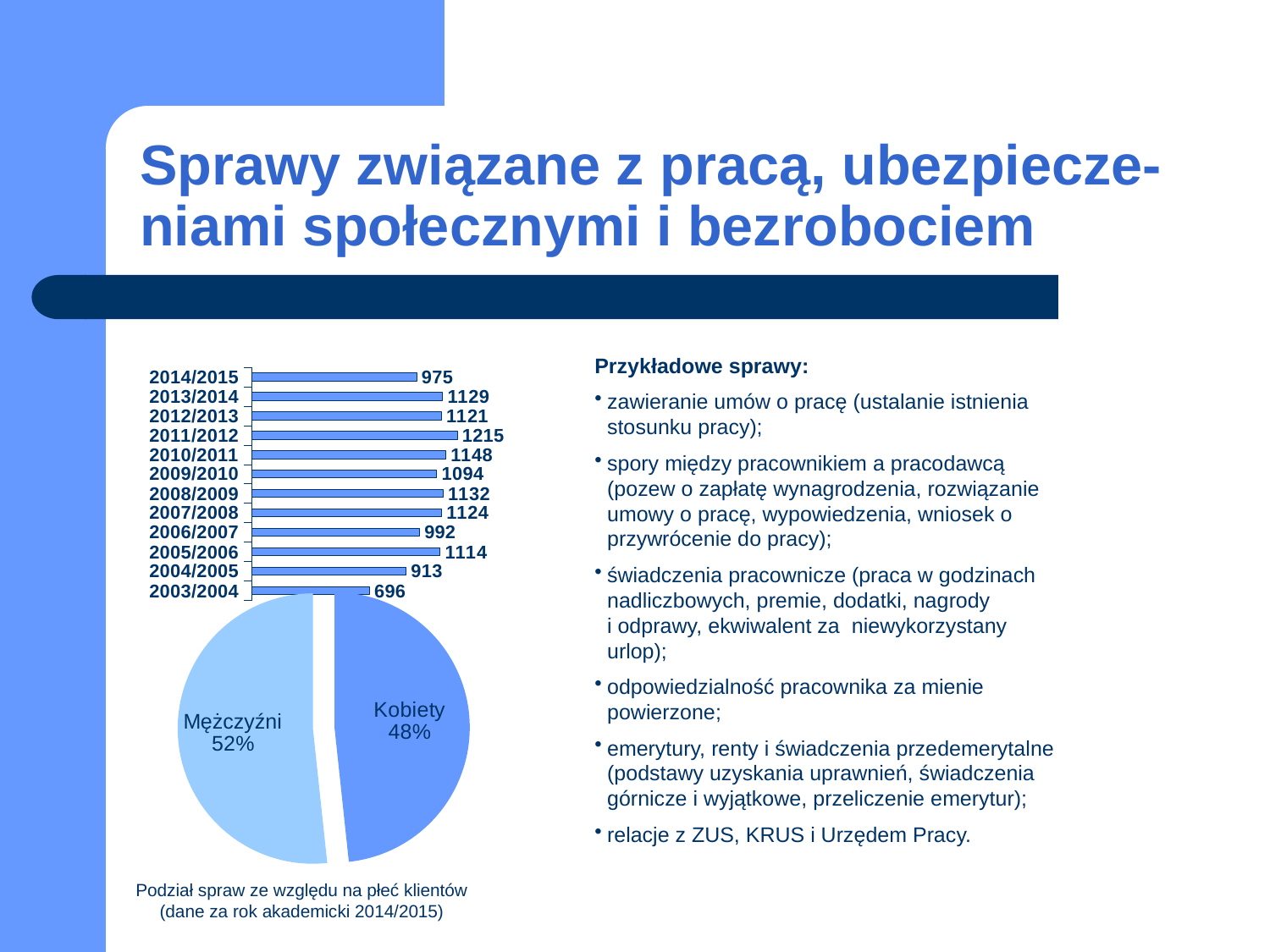
What kind of chart is the upper chart on the slide? bar chart In the bar chart, what is the value for 2011/2012? 1215 How many academic years are shown in the bar chart? 12 In the bar chart, what is the value for 2003/2004? 696 In the bar chart, which is larger, the value for 2008/2009 or the value for 2009/2010? 2008/2009 In the bar chart, which academic year has the lowest value? 2003/2004 In the pie chart, what share is labelled Mężczyźni? 52% In the bar chart, which academic year has the highest value? 2011/2012 In the pie chart, what share is labelled Kobiety? 48% In the bar chart, what is the difference between the values for 2013/2014 and 2014/2015? 154 In the bar chart, what is the value for 2014/2015? 975 What kind of chart is the lower chart on the slide? pie chart